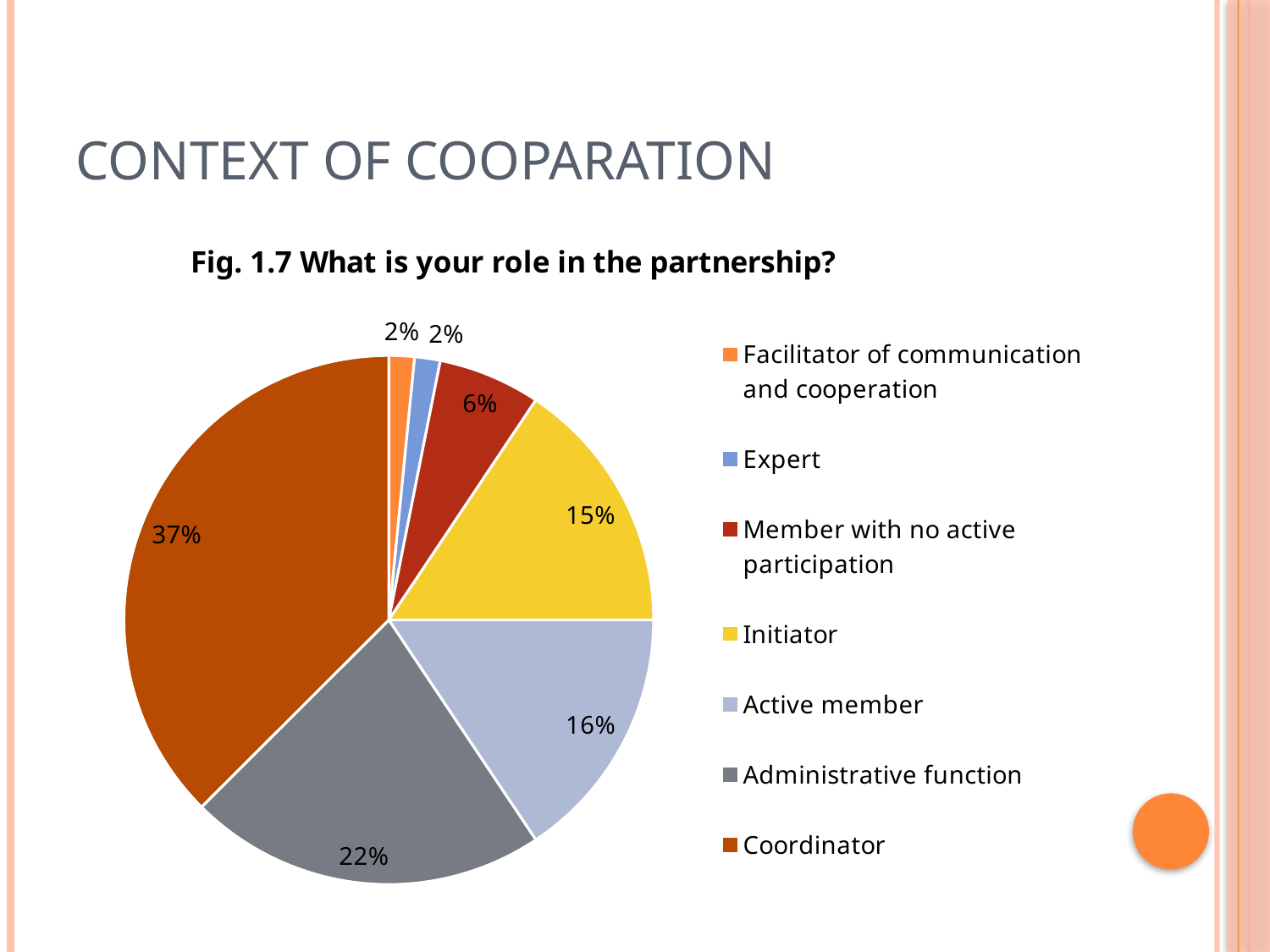
What type of chart is shown on the slide? pie chart What is the difference in percentage points between Coordinator and Administrative function? 15 What share of the pie does Coordinator represent? 37% What is the value for Member with no active participation? 6% How many slices does the pie chart have? 7 Which role has the largest share of the pie? Coordinator What is the title of the chart? Fig. 1.7 What is your role in the partnership? What percentage is shown for Expert? 2% Which is larger, the share for Initiator or the share for Member with no active participation? Initiator What is the value for Active member? 16% What percentage is shown for Initiator? 15% What percentage is shown for Administrative function? 22%